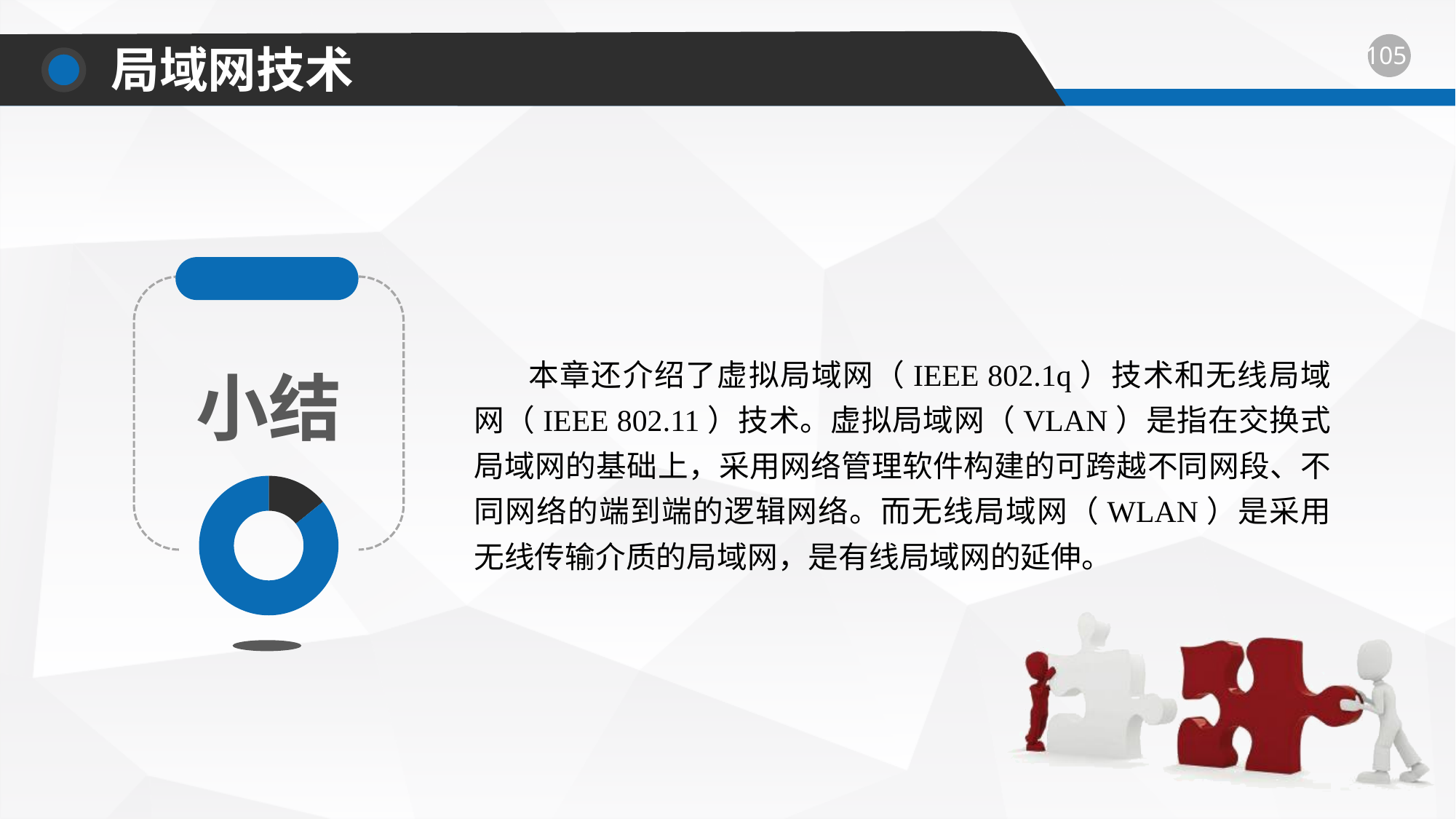
What colour is the largest slice of the doughnut chart? blue What kind of chart is shown on the left of the slide, below the word 小结? doughnut chart Does the doughnut chart on the slide show a legend? No In the doughnut chart, which slice is larger, the blue one or the dark grey one? the blue one How many slices does the doughnut chart on the slide have? 2